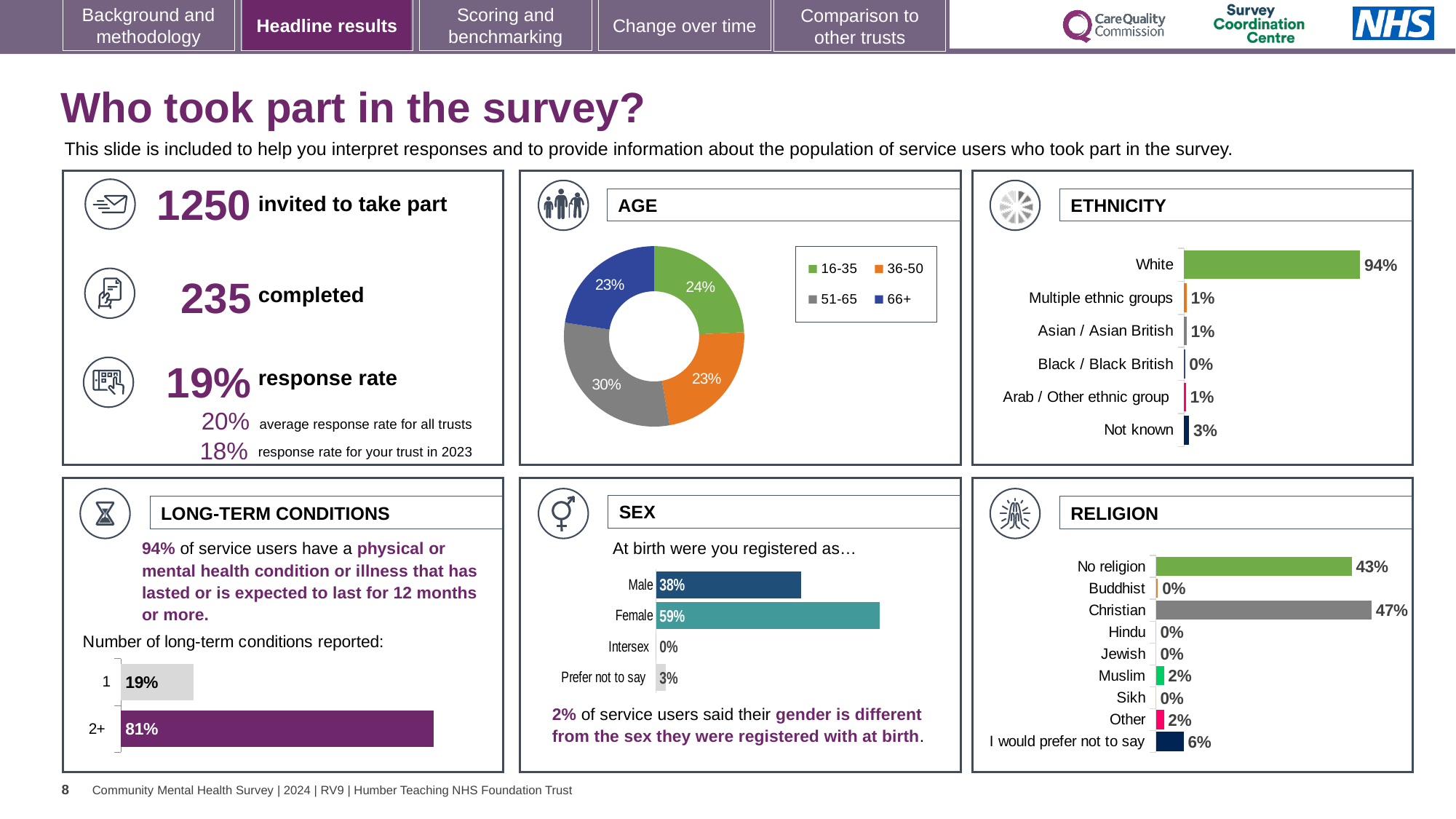
In the RELIGION chart, what is the value for I would prefer not to say? 6% In the SEX chart, what is the value for Prefer not to say? 3% In the AGE chart, which age group has the largest share? 51-65 How many categories are shown in the ETHNICITY chart? 6 In the ETHNICITY chart, which category has the highest value? White In the SEX chart, what is the difference between the Female and Male values? 21% In the ETHNICITY chart, what is the value for Not known? 3% What kind of chart is the AGE chart? Doughnut chart How many entries does the legend of the AGE chart list? 4 In the LONG-TERM CONDITIONS chart, what percentage reported 2+ conditions? 81% In the RELIGION chart, which is larger, Christian or No religion? Christian In the AGE chart, what share of respondents were aged 51-65? 30%